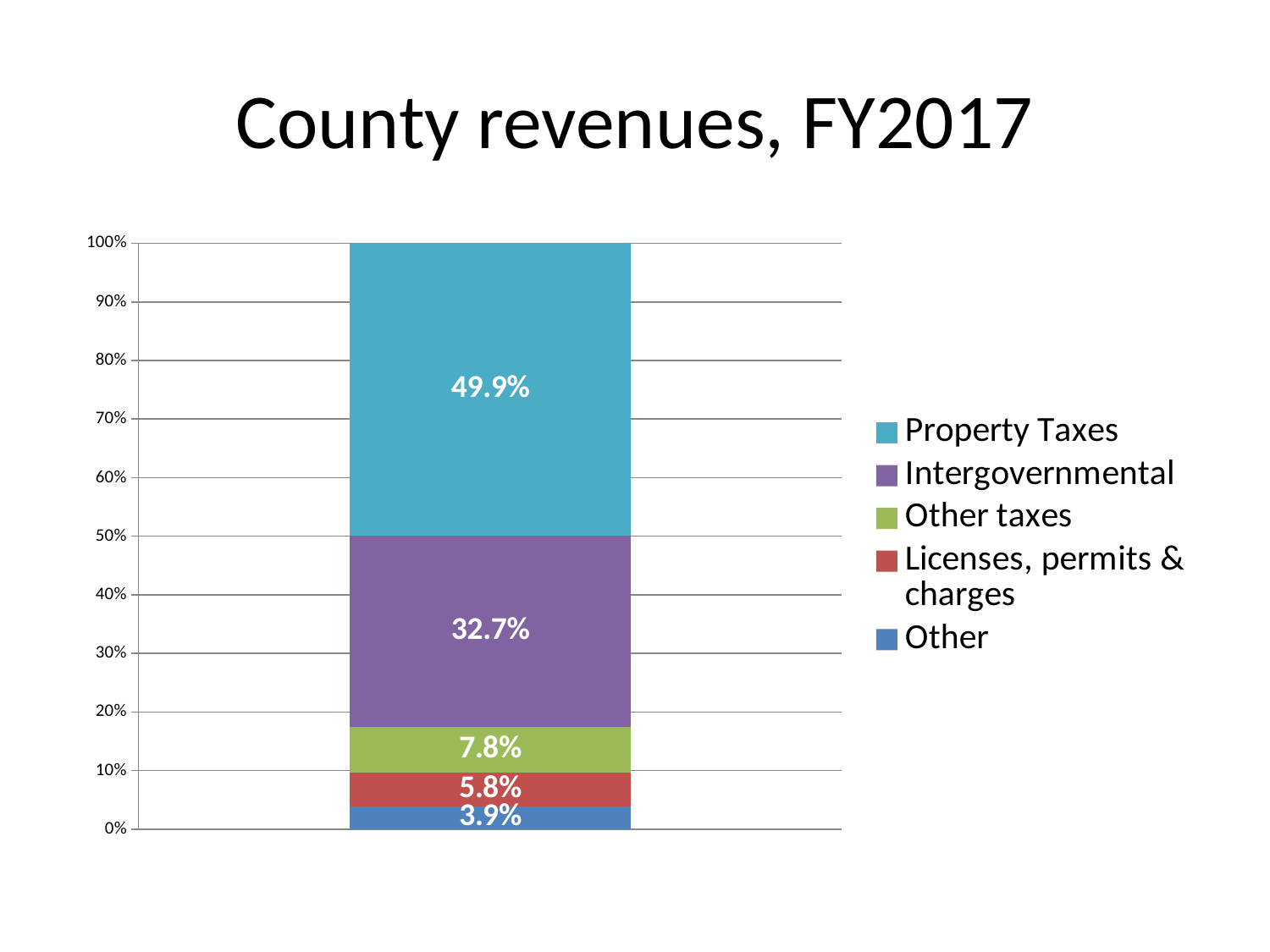
Which revenue source has the smallest share? Other What share of county revenues comes from Property Taxes? 49.9% How many series does the legend list? 5 Which revenue source has the largest share? Property Taxes What is the value shown for Intergovernmental revenue? 32.7% What is the value for Licenses, permits & charges? 5.8% What type of chart is shown on the slide? Stacked bar chart Which is larger, Intergovernmental or Other taxes? Intergovernmental What is the difference between Other taxes and Licenses, permits & charges? 2.0 percentage points What percentage is labelled for Other taxes? 7.8% How many percentage points larger is Property Taxes than Intergovernmental? 17.2 What is the value for the Other category? 3.9%